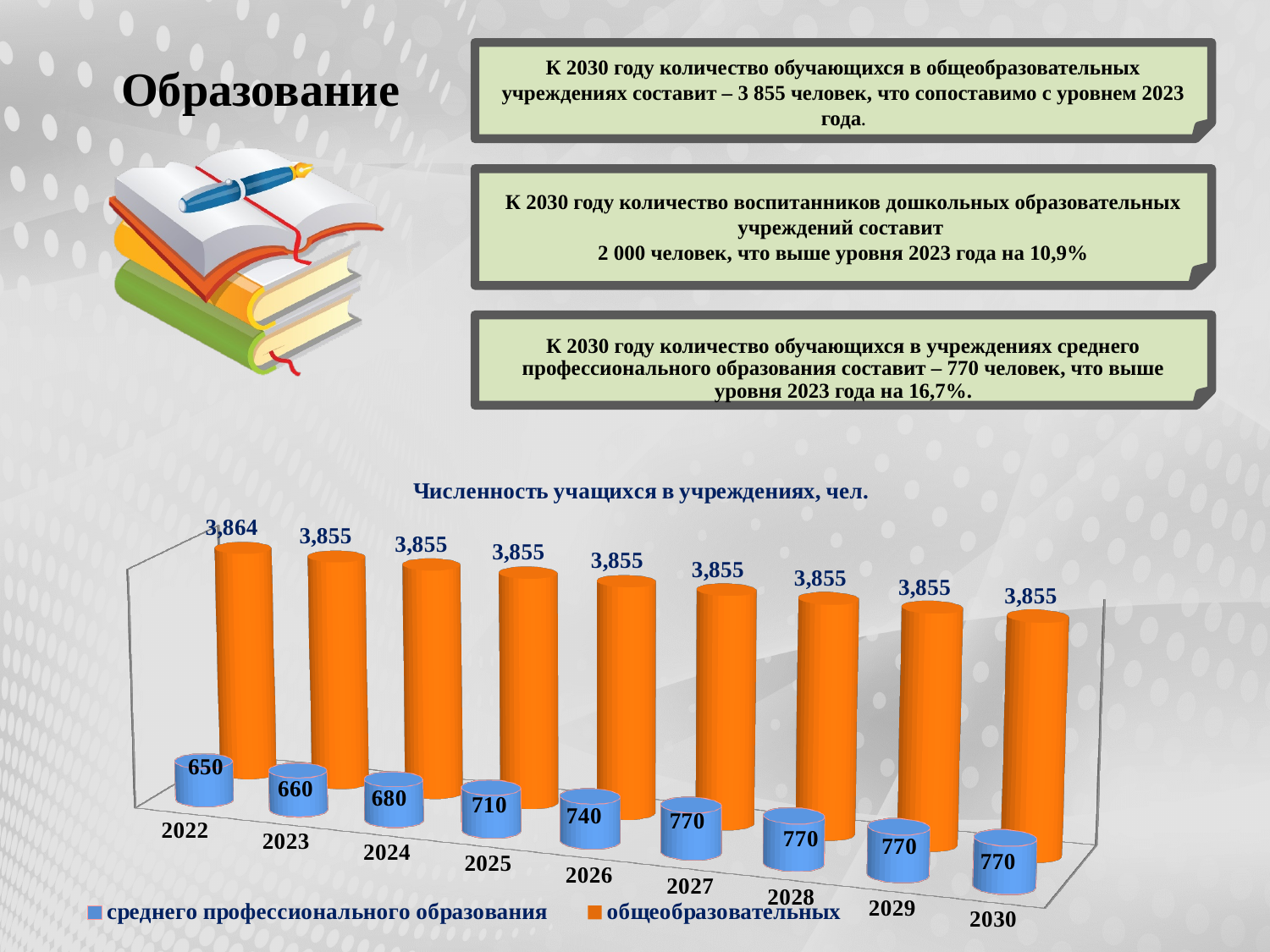
Which is larger in 2024: the value for общеобразовательных or for среднего профессионального образования? общеобразовательных What is the value for общеобразовательных in 2022? 3,864 In which year is the value for среднего профессионального образования lowest? 2022 What is the difference between the среднего профессионального образования values for 2022 and 2030? 120 What is the value for среднего профессионального образования in 2025? 710 How many years are shown on the x axis? 9 What kind of chart is shown? bar chart What is the value for среднего профессионального образования in 2030? 770 In which year is the value for общеобразовательных highest? 2022 What is the difference between the общеобразовательных values for 2022 and 2023? 9 What is the value for общеобразовательных in 2027? 3,855 How many series does the legend list? 2